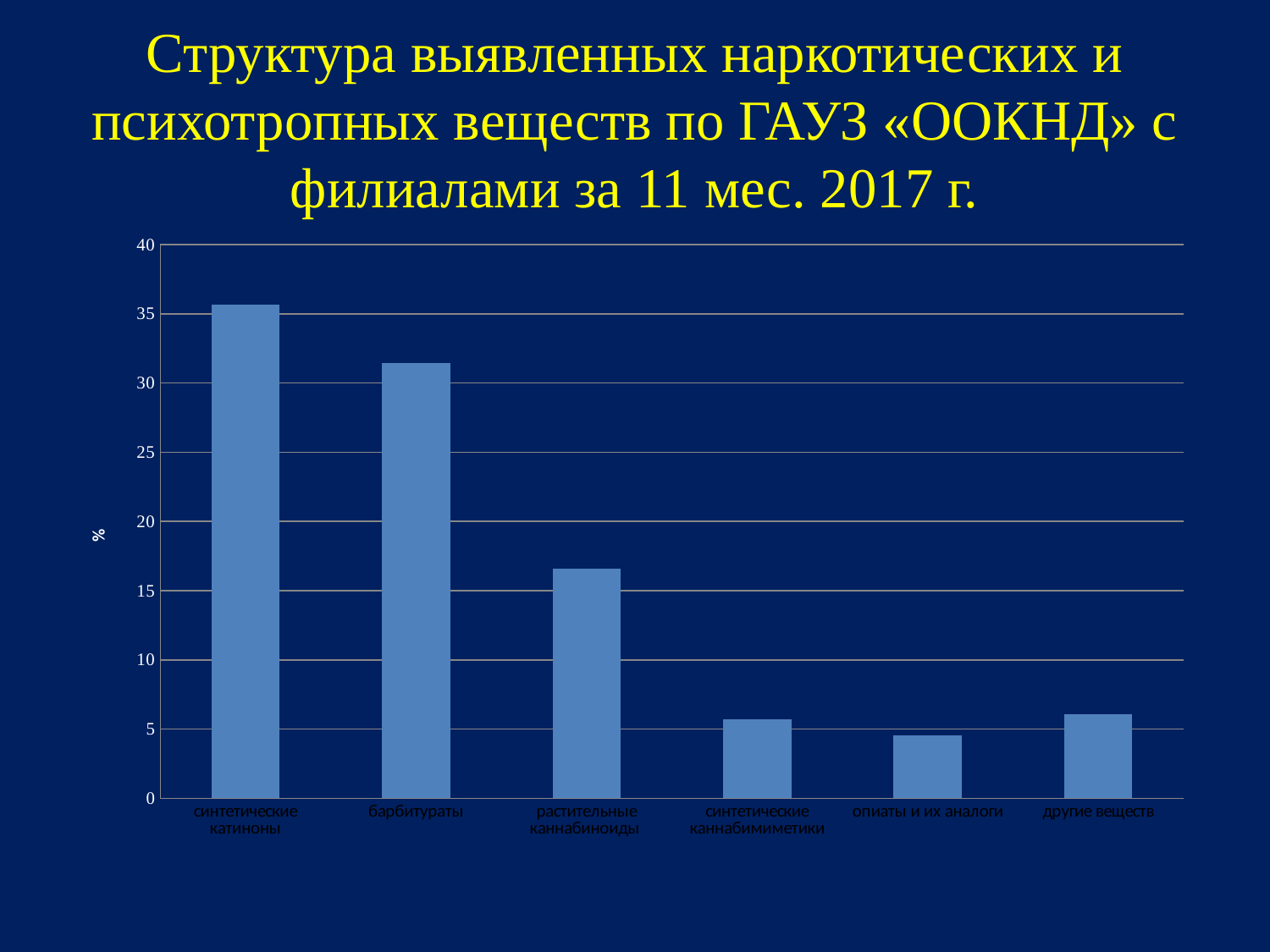
Is the value for другие веществ greater or less than 5? greater Is the value for барбитураты greater or less than 30? greater What kind of chart is shown on the slide? bar chart Which category has the highest value in the chart? синтетические катиноны Which category has the lowest value in the chart? опиаты и их аналоги Is the value for растительные каннабиноиды greater or less than 15? greater What is the label on the vertical axis of the chart? % Which is larger, the value for растительные каннабиноиды or the value for другие веществ? растительные каннабиноиды Which is larger, the value for синтетические катиноны or the value for барбитураты? синтетические катиноны How many categories are shown on the x axis of the chart? 6